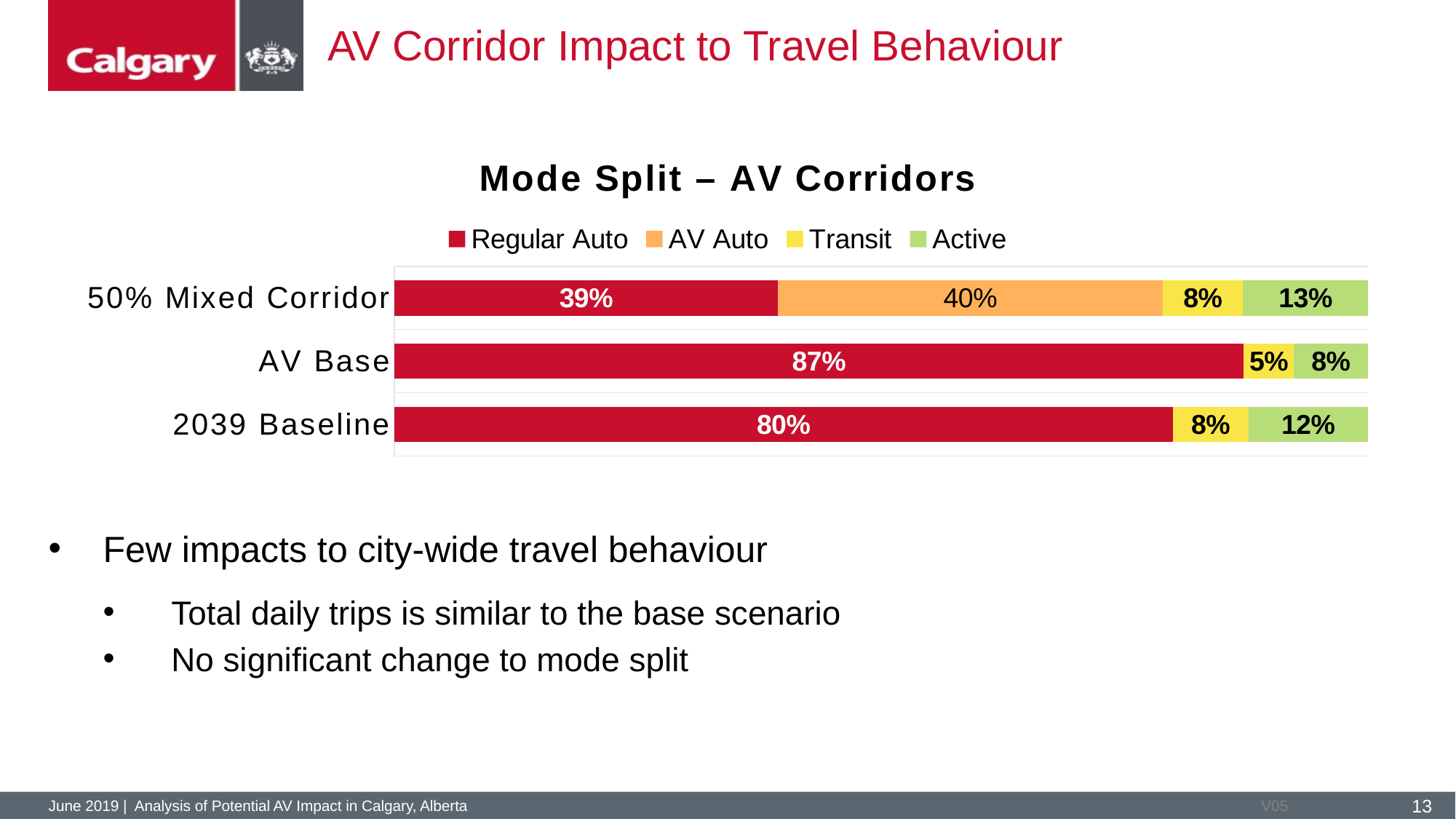
What is the AV Auto value for the 50% Mixed Corridor scenario? 40% What is the Active value for the 2039 Baseline? 12% Which scenario has the lowest Regular Auto share? 50% Mixed Corridor How many scenarios (bars) are shown in the chart? 3 What kind of chart is shown on the slide? Stacked bar chart What is the difference between the Regular Auto share for AV Base and for the 2039 Baseline? 7% How many series does the legend list? 4 What is the Regular Auto value for the 50% Mixed Corridor scenario? 39% What is the total of the stacked bar for the 50% Mixed Corridor? 100% Which scenario has the highest Regular Auto share? AV Base Is the Active share larger for the 50% Mixed Corridor or for AV Base? 50% Mixed Corridor What is the Transit value for AV Base? 5%